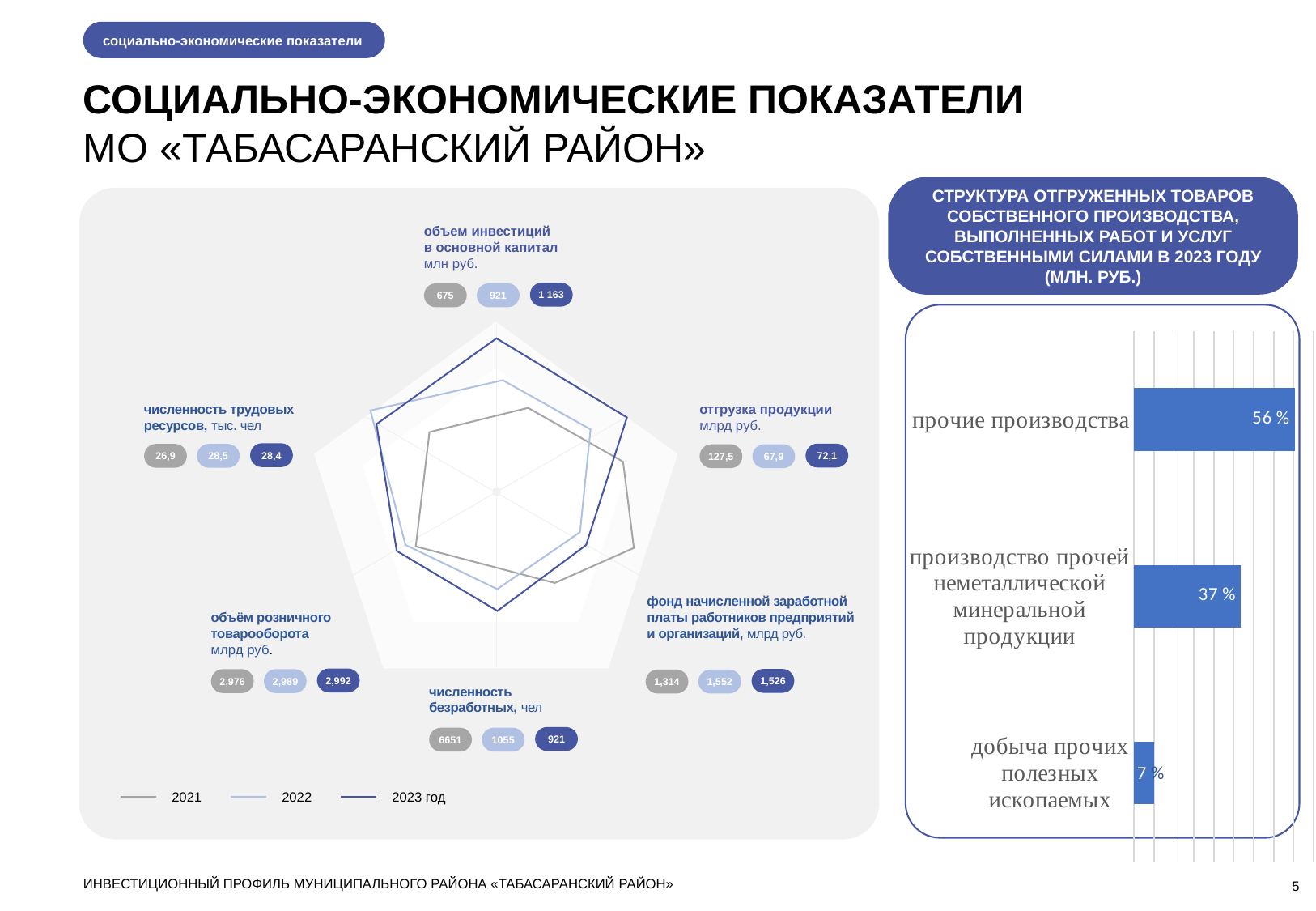
What kind of chart is the right-hand chart (structure of shipped goods in 2023)? bar chart On the right-hand chart (structure of shipped goods in 2023), what is the value for «прочие производства»? 56 % On the left-hand radar chart, which is larger for «отгрузка продукции»: the 2021 value or the 2023 value? 2021 On the right-hand chart (structure of shipped goods in 2023), what is the value for «добыча прочих полезных ископаемых»? 7 % On the left-hand radar chart, how many series does the legend list? 3 On the left-hand radar chart, what is the difference between the 2022 and 2021 values of «объем инвестиций в основной капитал»? 246 On the right-hand chart (structure of shipped goods in 2023), how many categories are shown? 3 On the left-hand radar chart, what is the value of «объем инвестиций в основной капитал» for 2023? 1 163 On the right-hand chart (structure of shipped goods in 2023), which category has the lowest value? добыча прочих полезных ископаемых On the left-hand radar chart, what is the value of «фонд начисленной заработной платы работников предприятий и организаций» for 2022? 1,552 On the right-hand chart (structure of shipped goods in 2023), what is the difference between «прочие производства» and «производство прочей неметаллической минеральной продукции»? 19 % On the left-hand radar chart, what is the value of «численность безработных» for 2021? 6651